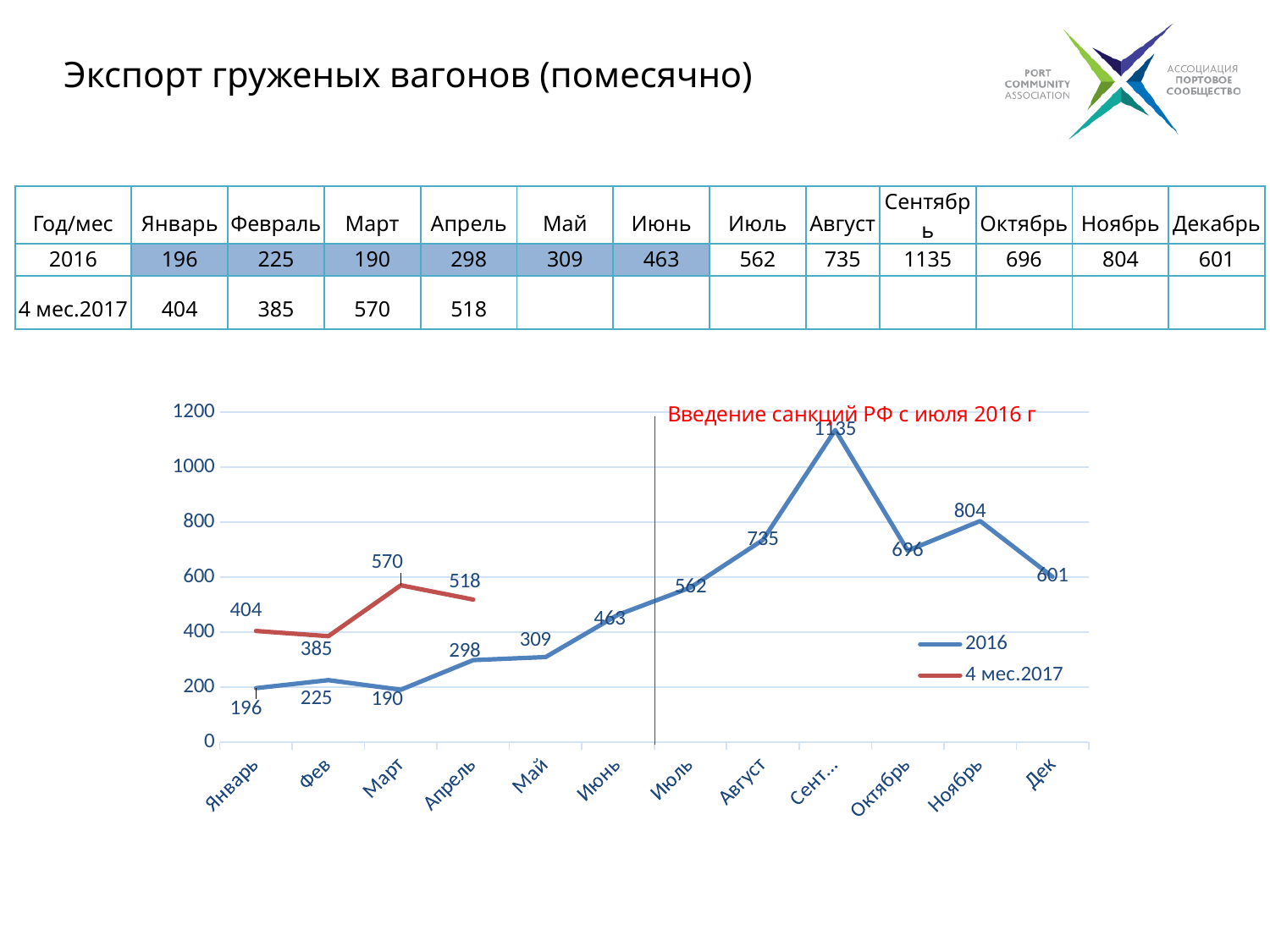
Which month has the lowest value in the 2016 series? Март What is the value for Март in the 4 мес.2017 series? 570 What is the difference between the Ноябрь and Декабрь values in the 2016 series? 203 Does the 2016 series rise or fall from Июнь to Сентябрь? rise What does the red annotation on the chart say? Введение санкций РФ с июля 2016 г What is the difference between the Апрель values of the 4 мес.2017 series and the 2016 series? 220 Which month has the highest value in the 2016 series? Сентябрь How many series does the chart legend list? 2 Which is larger: the Январь value for 2016 or for 4 мес.2017? 4 мес.2017 What is the value for Сентябрь in the 2016 series? 1135 How many months have data points in the 4 мес.2017 series? 4 What type of chart is shown on the slide? line chart